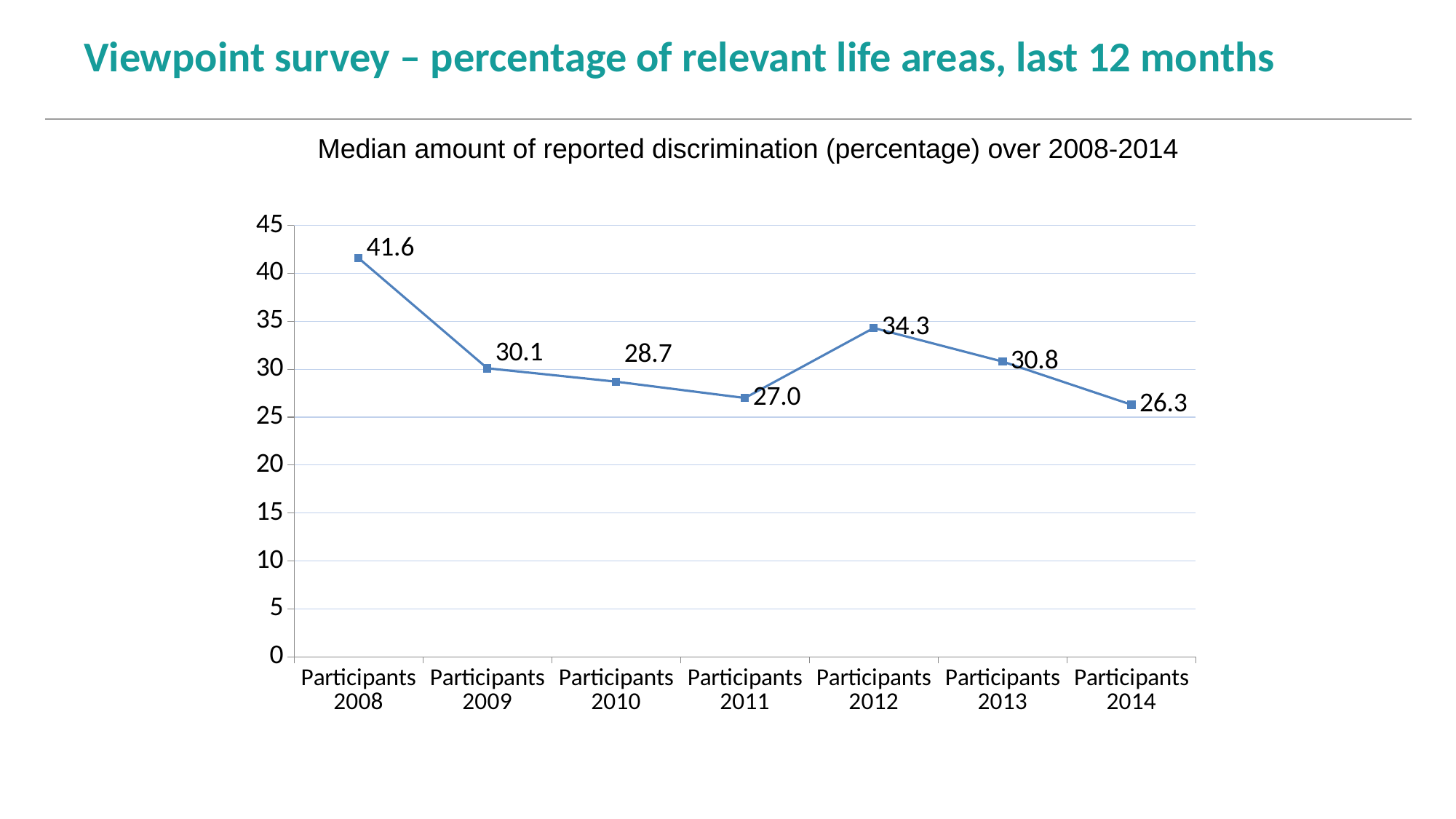
What is the value for Participants 2014? 26.3 What is the difference between the values for Participants 2012 and Participants 2013? 3.5 What is the title of the chart? Median amount of reported discrimination (percentage) over 2008-2014 What is the difference between the values for Participants 2008 and Participants 2009? 11.5 Which category has the highest value? Participants 2008 What is the value for Participants 2008? 41.6 Which category has the lowest value? Participants 2014 What is the value for Participants 2011? 27.0 Which is larger, the value for Participants 2010 or Participants 2012? Participants 2012 What kind of chart is shown on the slide? line chart How many data points are plotted on the chart? 7 Is the value for Participants 2012 greater or less than 30? greater